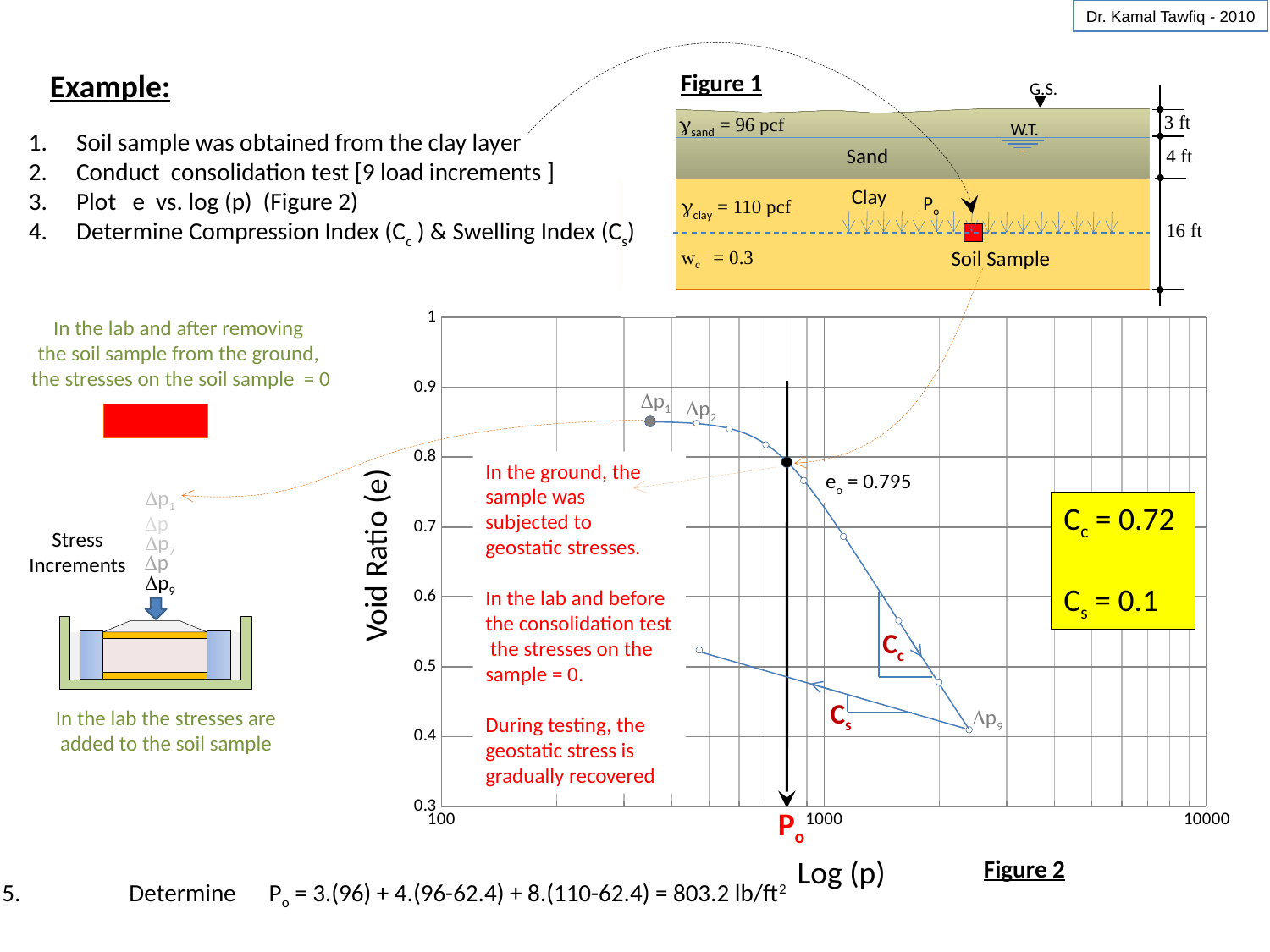
Which is larger, the Compression Index C_c or the Swelling Index C_s? C_c In Figure 2, is the void ratio at the point labelled Δp1 greater or less than 0.8? greater What is the computed value of P_o given at the bottom of the slide? 803.2 lb/ft² What is the difference between C_c and C_s? 0.62 In Figure 2, is the void ratio at the point labelled Δp9 greater or less than 0.5? less In Figure 2, what is the Swelling Index C_s shown in the yellow box? 0.1 In Figure 2, what is the value of the initial void ratio e_o marked at P_o? 0.795 What kind of chart is Figure 2? line chart How many load increments were applied in the consolidation test plotted in Figure 2? 9 In Figure 2, does the void ratio rise or fall along the loading curve as p increases? fall What is the label of the vertical axis in Figure 2? Void Ratio (e) In Figure 2, what is the Compression Index C_c shown in the yellow box? 0.72